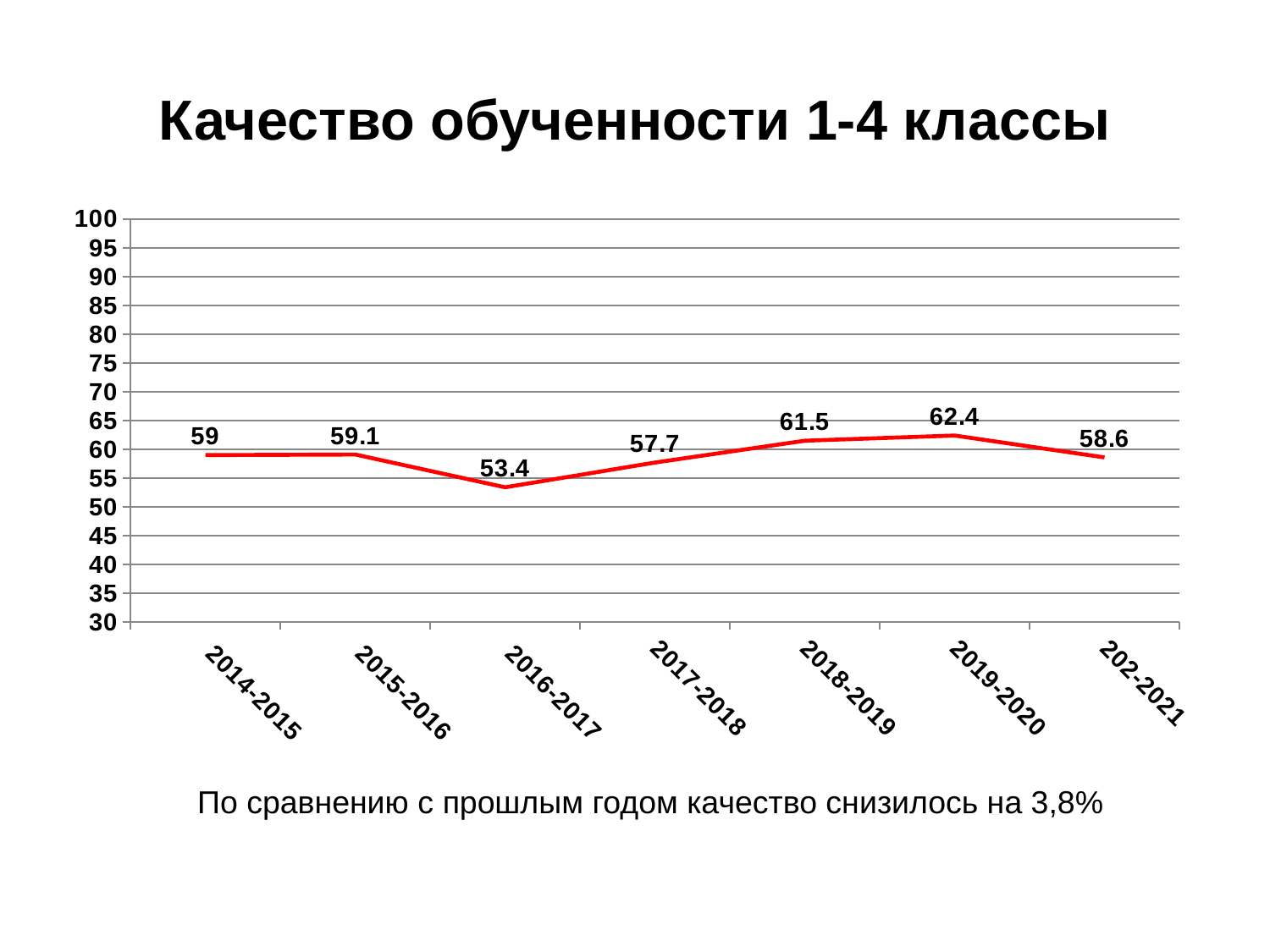
Which is larger, the value for 2017-2018 or the value for 2018-2019? 2018-2019 What is the difference between the values for 2019-2020 and 202-2021? 3.8 Which year has the highest value? 2019-2020 Does the value rise or fall from 2019-2020 to 202-2021? fall What kind of chart is shown on the slide? line chart Is the value for 2016-2017 greater or less than 55? less What is the value for 2014-2015? 59 How many data points are plotted on the chart? 7 What is the value for 2019-2020? 62.4 What is the value for 2016-2017? 53.4 What is the difference between the values for 2018-2019 and 2016-2017? 8.1 Which year has the lowest value? 2016-2017